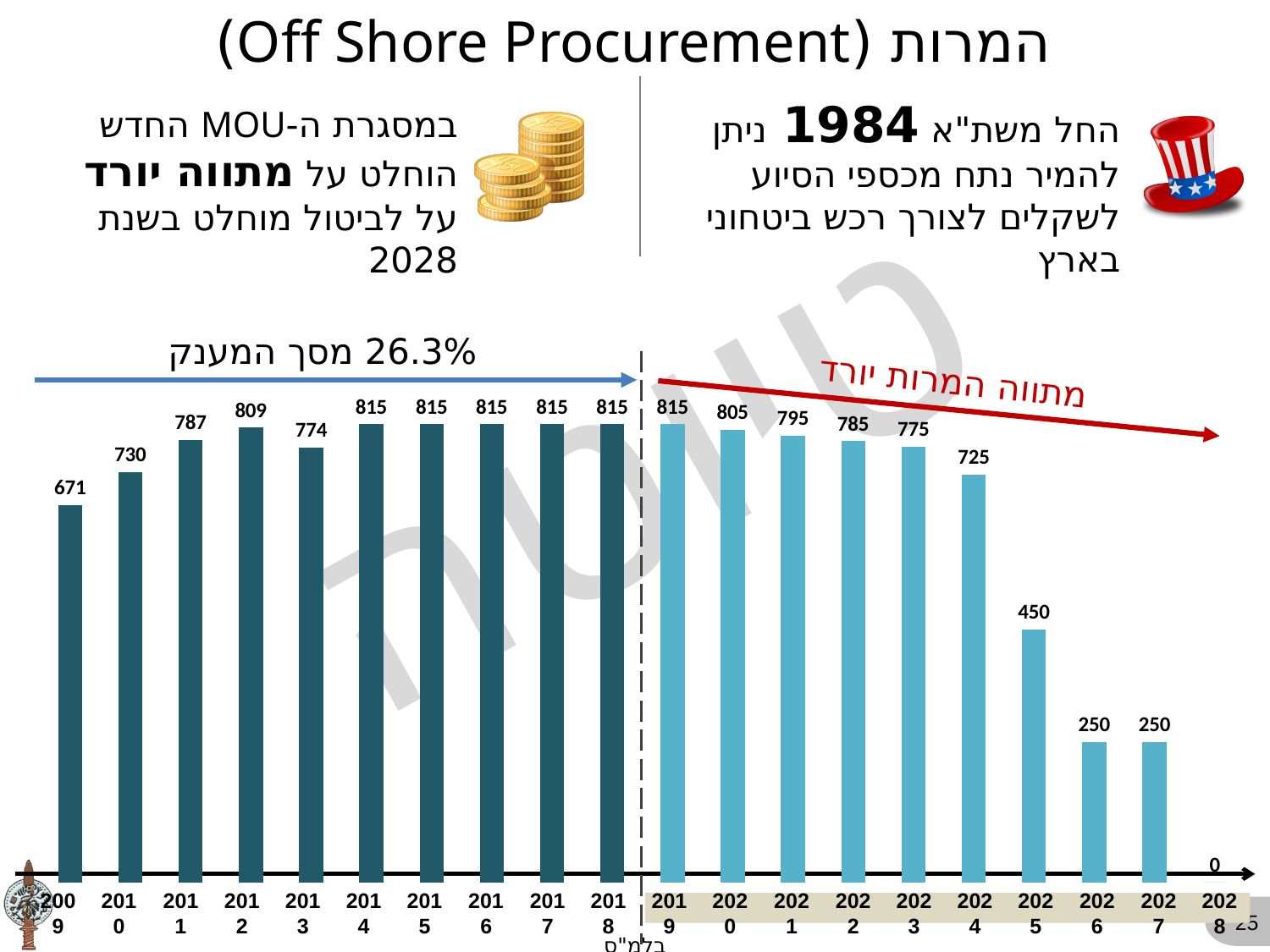
Which is larger, the value for 2023 or the value for 2026? 2023 Which is larger, the value for 2010 or the value for 2011? 2011 Which year has the lowest value? 2028 What is the value for 2025? 450 What is the difference between the values for 2024 and 2025? 275 What kind of chart is shown on the slide? bar chart How many years are shown on the x axis? 20 What is the difference between the values for 2012 and 2013? 35 Do the values rise or fall from 2019 to 2028? fall What is the value for 2009? 671 What is the value for 2024? 725 What is the value for 2028? 0